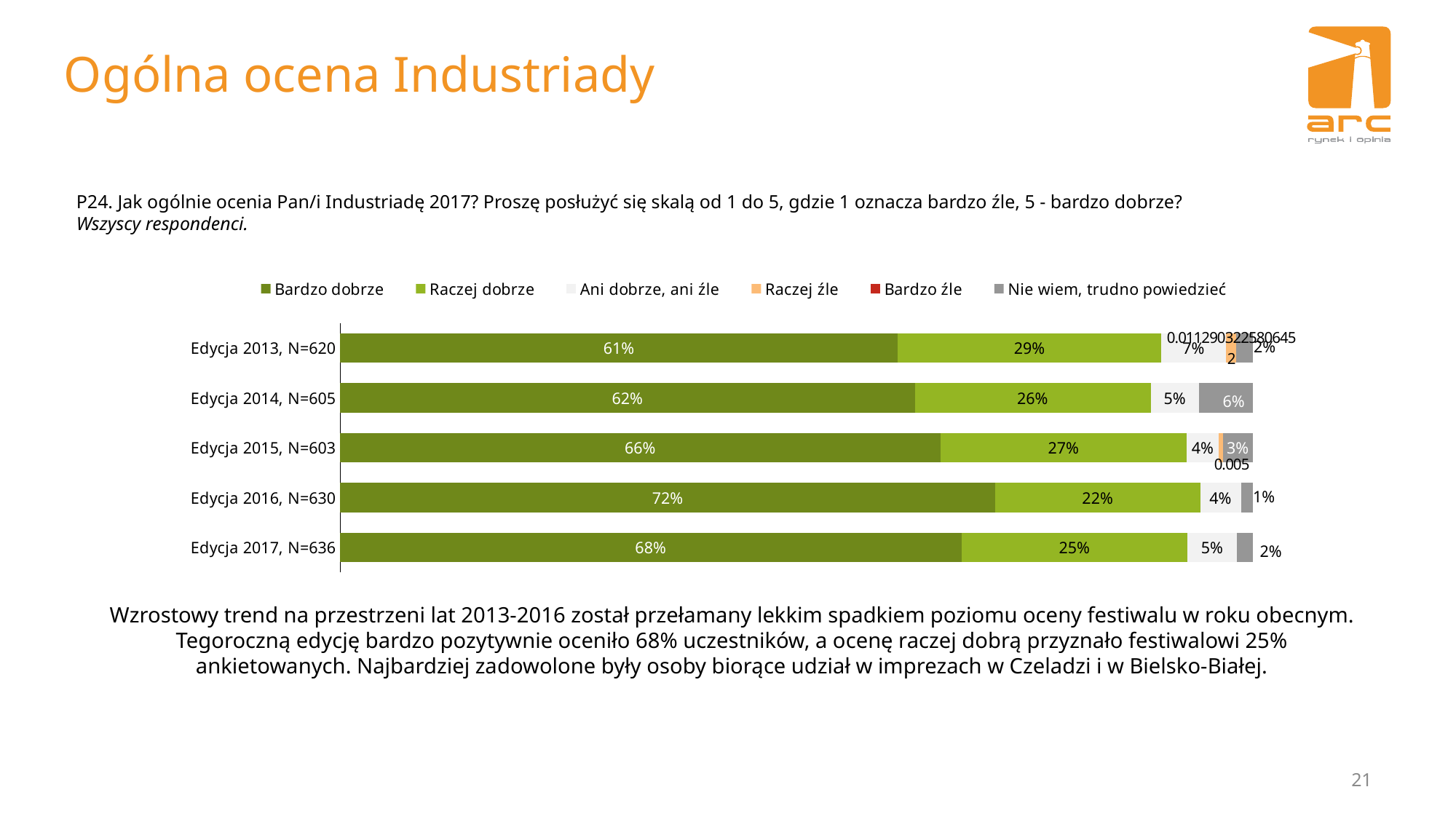
What kind of chart is shown on the slide? Stacked bar chart Which has the larger "Raczej dobrze" value: Edycja 2014, N=605 or Edycja 2015, N=603? Edycja 2015, N=603 Which edition has the highest "Bardzo dobrze" value? Edycja 2016, N=630 What is the value for "Ani dobrze, ani źle" for Edycja 2013, N=620? 7% What is the value for "Nie wiem, trudno powiedzieć" for Edycja 2014, N=605? 6% What is the value for "Bardzo dobrze" for Edycja 2017, N=636? 68% Does the "Bardzo dobrze" value rise or fall from Edycja 2013 to Edycja 2016? Rise How many editions (categories) are shown in the chart? 5 What is the difference between the "Bardzo dobrze" values for Edycja 2016, N=630 and Edycja 2017, N=636? 4 percentage points What is the value for "Raczej dobrze" for Edycja 2013, N=620? 29% How many series does the legend list? 6 Which edition has the lowest "Bardzo dobrze" value? Edycja 2013, N=620